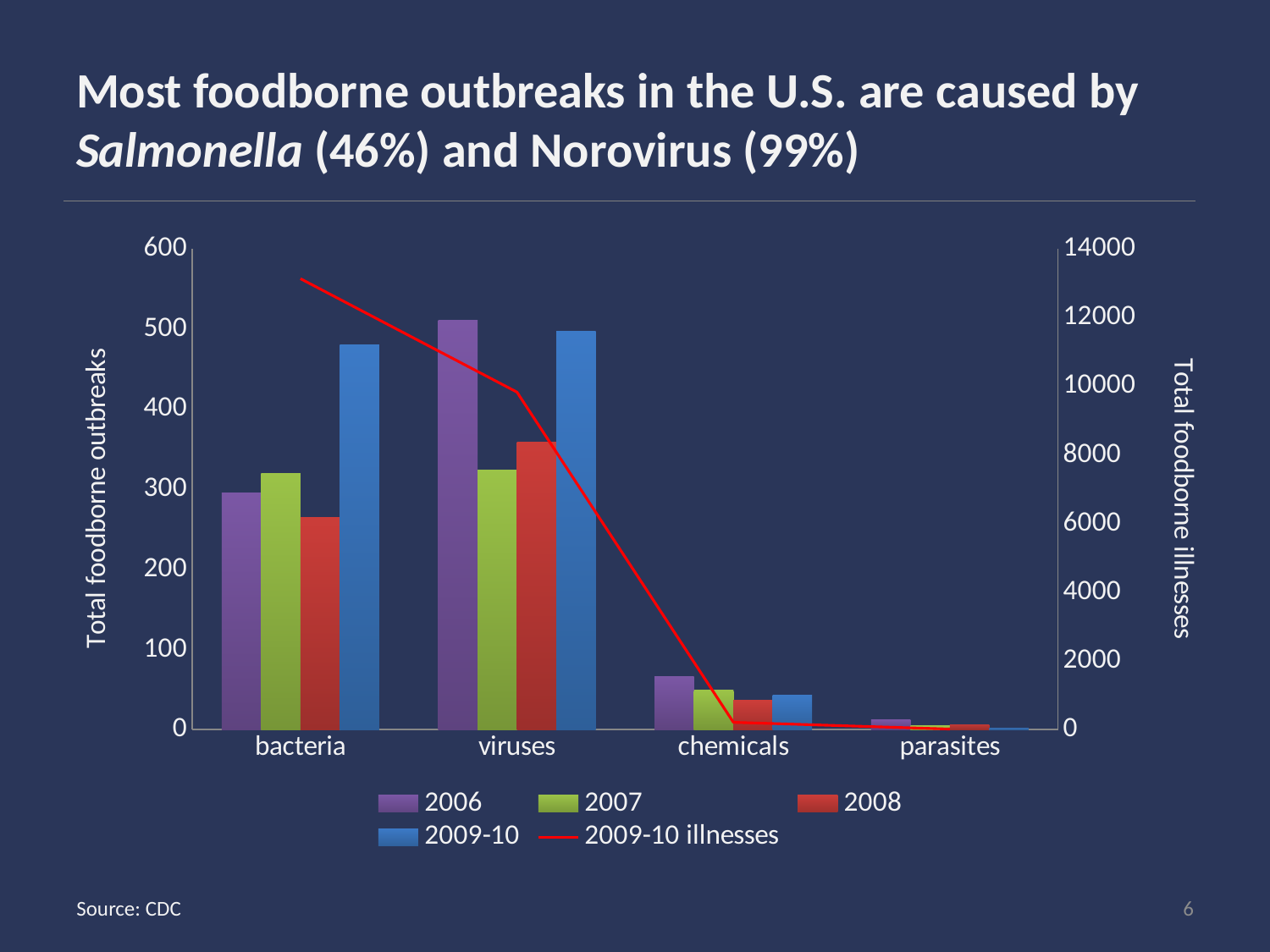
Which category has the lowest 2009-10 bar? parasites For chemicals, which is larger: the 2006 bar or the 2008 bar? 2006 How many series does the legend list? 5 Is the 2008 value for bacteria greater or less than 300 outbreaks? less Which category has the highest 2006 bar? viruses How many categories are shown on the x axis? 4 Does the 2009-10 illnesses line rise or fall from bacteria to parasites? fall Is the 2006 value for viruses greater or less than 400 outbreaks? greater For bacteria, which is larger: the 2006 bar or the 2009-10 bar? 2009-10 Is the 2009-10 value for bacteria greater or less than 400 outbreaks? greater What kind of chart is shown on the slide? bar chart (with a line series)